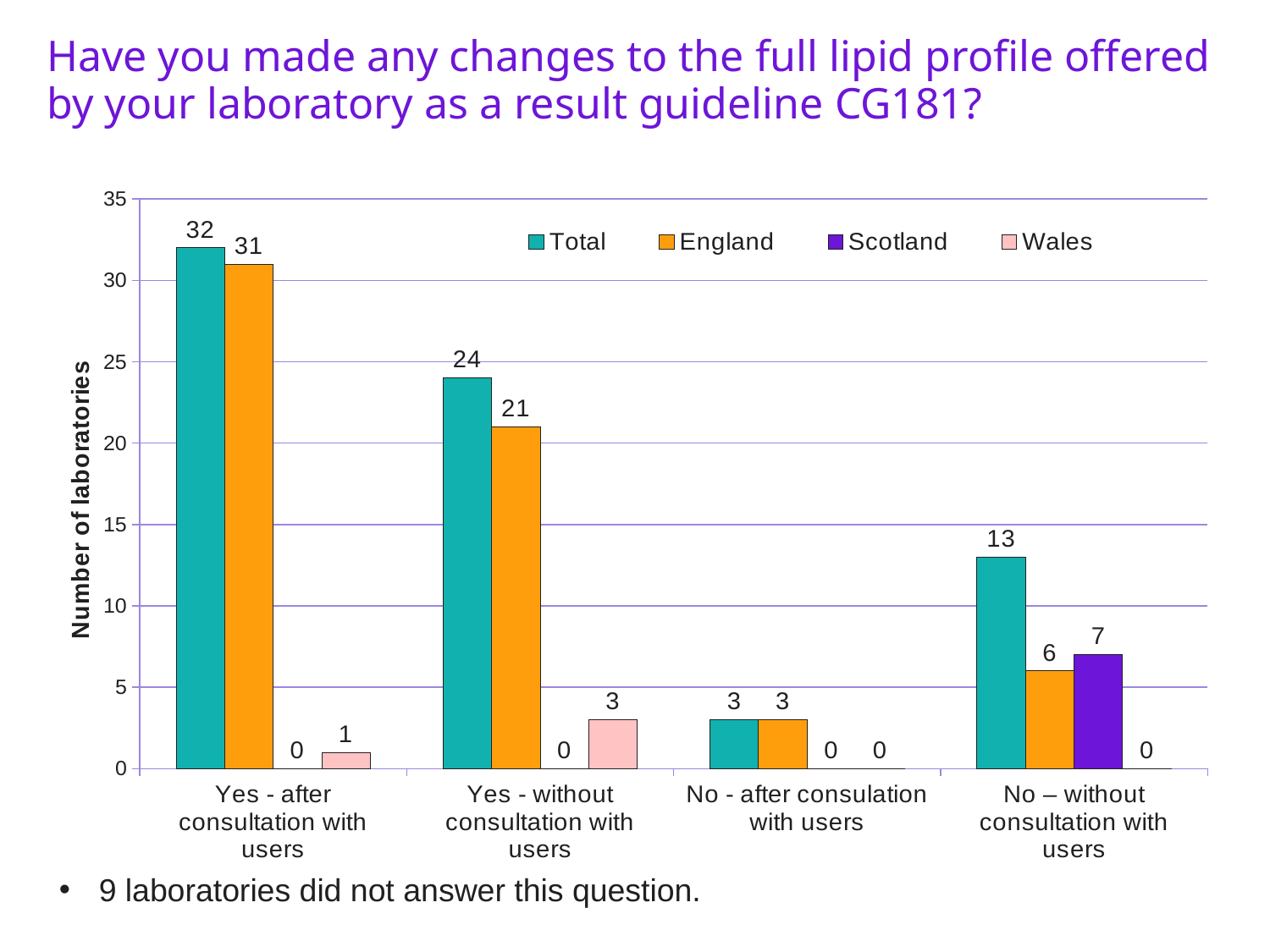
What is the Total value for 'Yes - after consultation with users'? 32 What is the England value for 'Yes - without consultation with users'? 21 Which category has the lowest Total value? No - after consultation with users What is the Scotland value for 'No – without consultation with users'? 7 How many series does the legend list? 4 Which category has the highest Total value? Yes - after consultation with users What is the difference between the Total and England values for 'No – without consultation with users'? 7 What is the label of the y axis? Number of laboratories What kind of chart is shown on the slide? Bar chart For 'No – without consultation with users', which is larger, the England value or the Scotland value? Scotland What is the Wales value for 'Yes - without consultation with users'? 3 How many response categories are shown on the x axis? 4